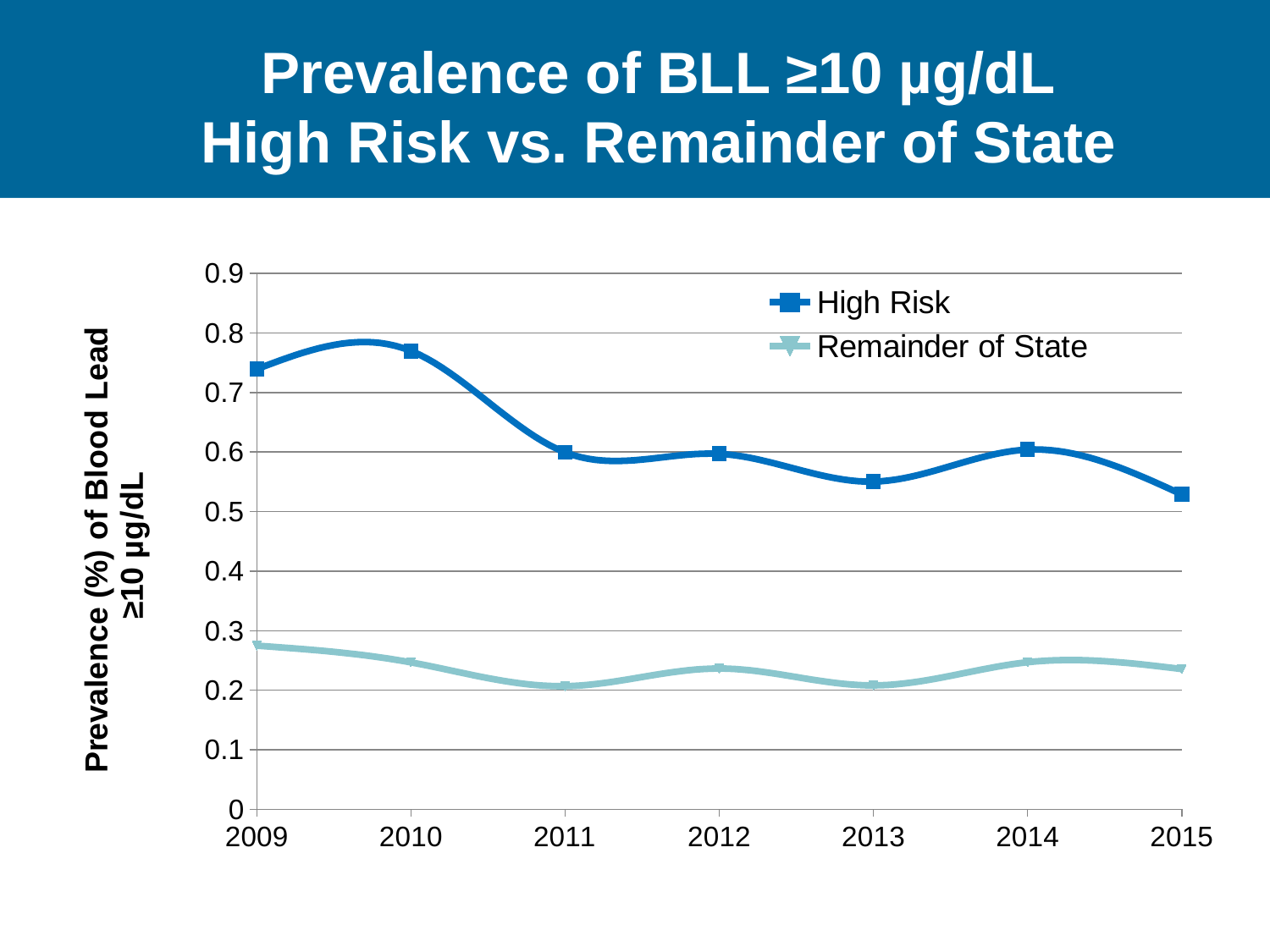
Which series has the higher value in 2012, High Risk or Remainder of State? High Risk Is the High Risk value for 2009 greater or less than 0.7? greater Is the Remainder of State value for 2009 greater or less than 0.3? less Is the High Risk value for 2015 greater or less than 0.5? greater What kind of chart is shown on the slide? line chart How many years are plotted along the x axis? 7 What is the label on the y axis? Prevalence (%) of Blood Lead ≥10 µg/dL In which year is the High Risk prevalence highest? 2010 Does the High Risk prevalence rise or fall overall from 2009 to 2015? fall In which year is the Remainder of State prevalence highest? 2009 How many series does the legend list? 2